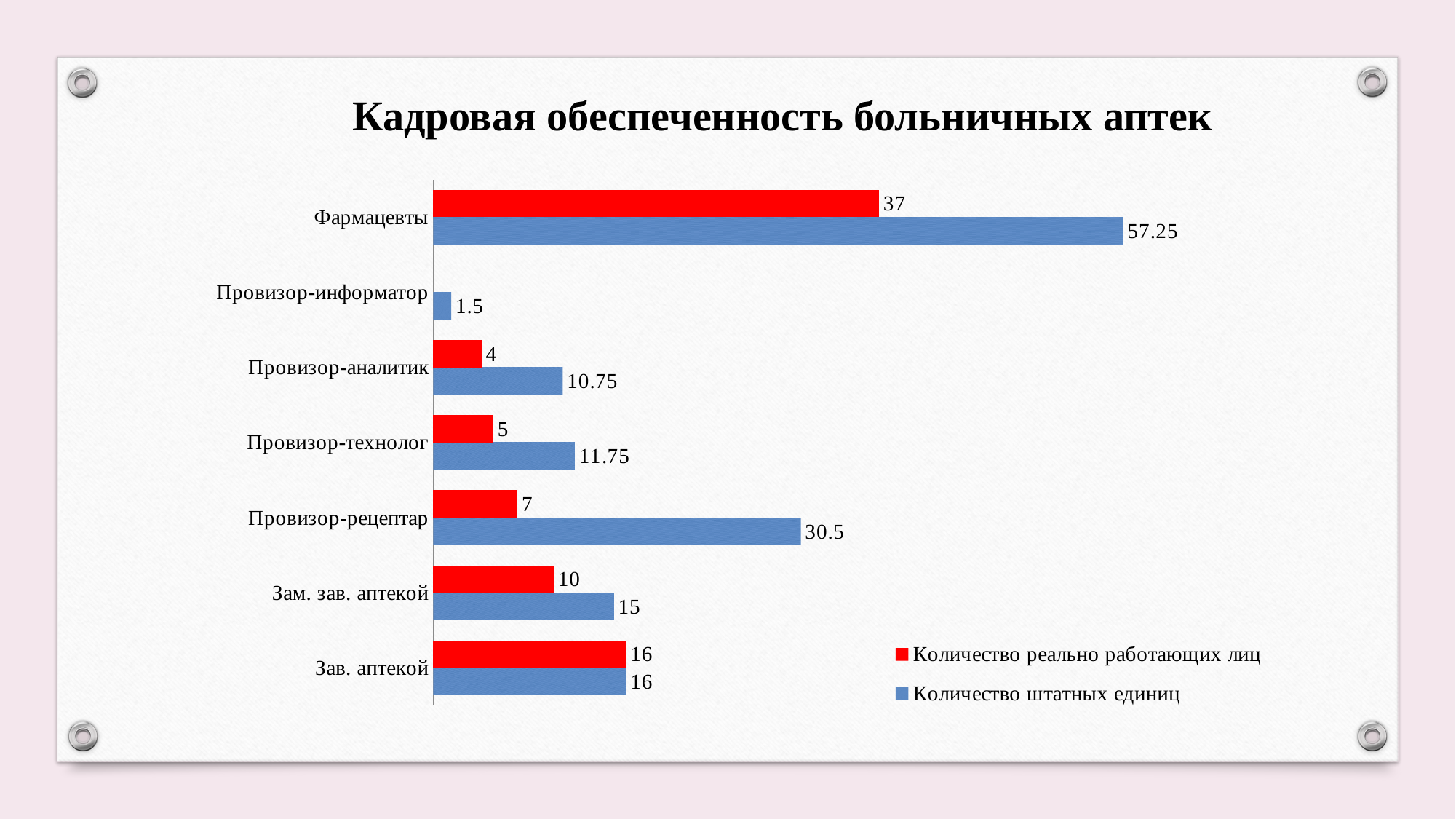
What kind of chart is shown on the slide? Bar chart What is the value of "Количество штатных единиц" for Провизор-информатор? 1.5 How many categories are shown on the chart? 7 Which category has the highest value for "Количество реально работающих лиц"? Фармацевты What is the difference between "Количество штатных единиц" and "Количество реально работающих лиц" for Провизор-рецептар? 23.5 What is the value of "Количество реально работающих лиц" for Провизор-рецептар? 7 Which is larger for Зам. зав. аптекой: "Количество штатных единиц" or "Количество реально работающих лиц"? Количество штатных единиц What is the difference between "Количество штатных единиц" and "Количество реально работающих лиц" for Фармацевты? 20.25 What is the value of "Количество штатных единиц" for Фармацевты? 57.25 How many series does the legend list? 2 Which category has the lowest value for "Количество штатных единиц"? Провизор-информатор What is the title of the chart? Кадровая обеспеченность больничных аптек